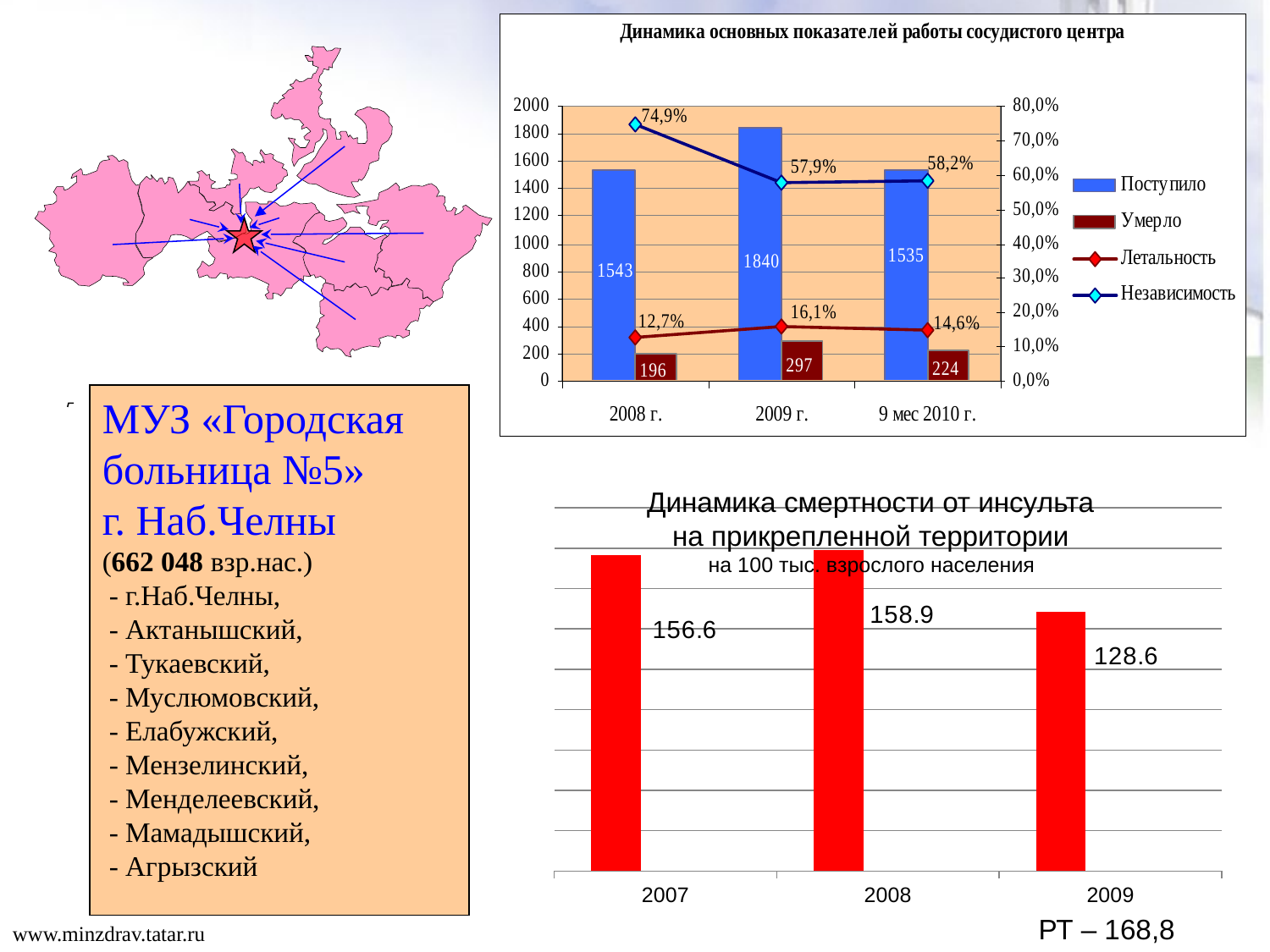
In the chart 'Динамика основных показателей работы сосудистого центра', what is the value of 'Поступило' for 2009 г.? 1840 What type of chart is the bottom chart 'Динамика смертности от инсульта на прикрепленной территории'? bar chart In the chart 'Динамика основных показателей работы сосудистого центра', how many series does the legend list? 4 In the bottom chart 'Динамика смертности от инсульта на прикрепленной территории', which year has the lowest value? 2009 In the chart 'Динамика основных показателей работы сосудистого центра', what is the 'Летальность' value for 9 мес 2010 г.? 14,6% In the chart 'Динамика основных показателей работы сосудистого центра', which period has the highest 'Поступило' value? 2009 г. In the chart 'Динамика основных показателей работы сосудистого центра', what is the difference between 'Умерло' in 2009 г. and 2008 г.? 101 In the bottom chart 'Динамика смертности от инсульта на прикрепленной территории', what is the difference between the 2007 and 2009 values? 28.0 In the chart 'Динамика основных показателей работы сосудистого центра', what is the value of 'Умерло' for 2008 г.? 196 In the bottom chart 'Динамика смертности от инсульта на прикрепленной территории', what is the value for 2008? 158.9 In the chart 'Динамика основных показателей работы сосудистого центра', what is the 'Независимость' value for 2008 г.? 74,9% In the chart 'Динамика основных показателей работы сосудистого центра', does the 'Независимость' line rise or fall from 2008 г. to 2009 г.? fall